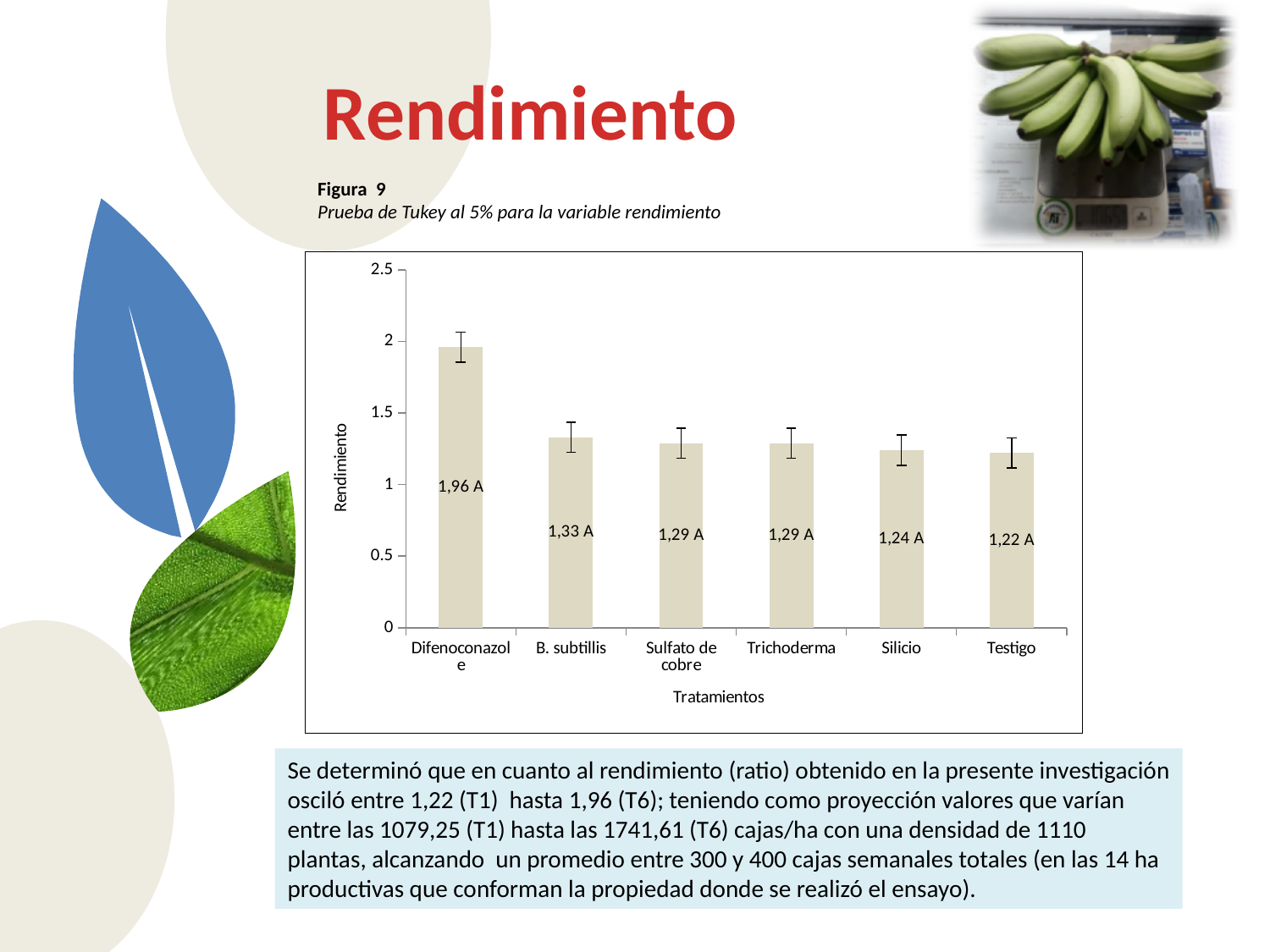
What is the data label on the bar for Difenoconazole? 1,96 A What is the label of the x axis of the chart? Tratamientos Which treatment has the lowest rendimiento? Testigo Which has a higher rendimiento value, B. subtillis or Silicio? B. subtillis What type of chart is shown on the slide? bar chart How many treatments (bars) are shown in the chart? 6 What is the data label on the bar for Silicio? 1,24 A What is the data label on the bar for Testigo? 1,22 A What is the difference between the rendimiento values for Difenoconazole and Testigo? 0,74 Is the value for Difenoconazole greater or less than 1.5? greater Which treatment has the highest rendimiento? Difenoconazole What is the data label on the bar for B. subtillis? 1,33 A